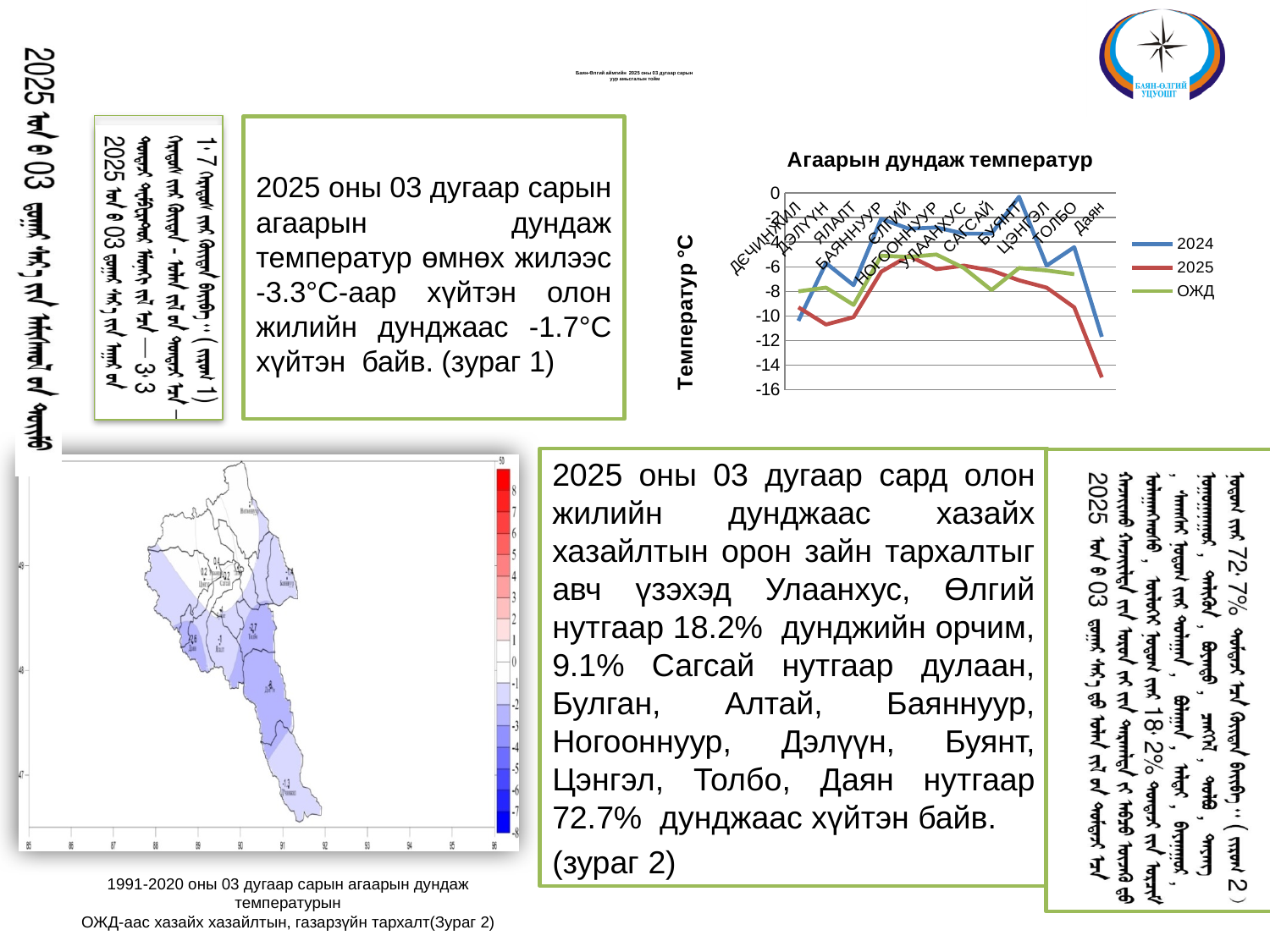
How many series does the legend of the "Агаарын дундаж температур" chart list? 3 What kind of chart is "Агаарын дундаж температур"? line chart In the "Агаарын дундаж температур" chart, does the 2025 series rise or fall from Толбо to Даян? fall In the "Агаарын дундаж температур" chart, is the 2024 value for Даян greater or less than -10? less What are the legend entries of the "Агаарын дундаж температур" chart? 2024, 2025, ОЖД How many categories are shown on the x axis of the "Агаарын дундаж температур" chart? 12 In the "Агаарын дундаж температур" chart, is the 2025 value for Даян greater or less than -12? less In the "Агаарын дундаж температур" chart, at which category does the 2025 series reach its lowest value? Даян In the "Агаарын дундаж температур" chart, is the 2024 value for Буянт greater or less than -4? greater What is the y-axis label of the "Агаарын дундаж температур" chart? Температур °C In the "Агаарын дундаж температур" chart, which series has the larger value at Даян, 2024 or 2025? 2024